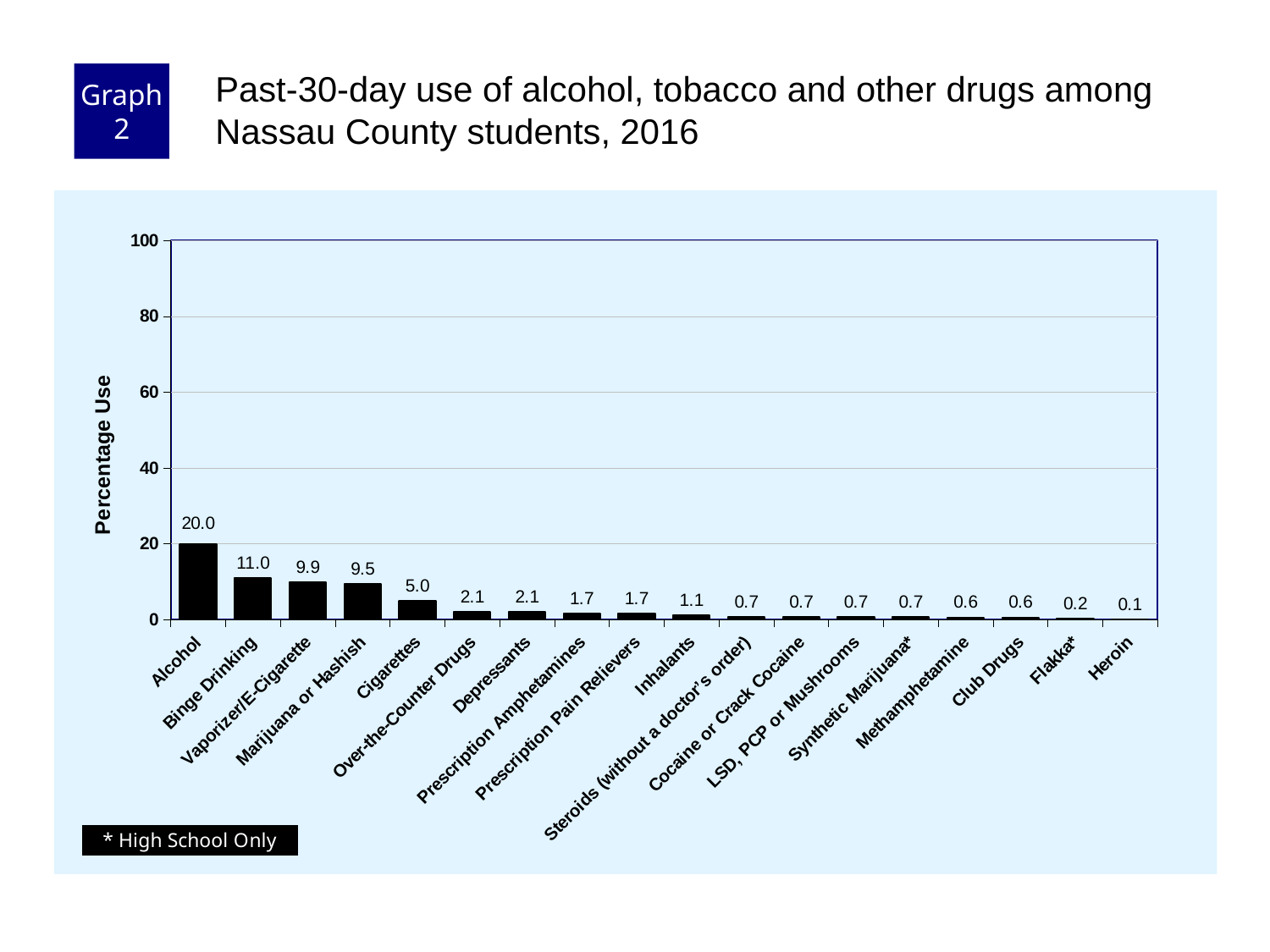
What is the past-30-day use percentage for Alcohol? 20.0 What is the value shown for Inhalants? 1.1 What is the difference between the values for Alcohol and Binge Drinking? 9.0 Which is larger, the value for Cigarettes or the value for Over-the-Counter Drugs? Cigarettes What is the value shown for Cigarettes? 5.0 How many categories are shown on the x axis? 18 Is the value for Binge Drinking greater or less than 20? less What is the difference between the values for Vaporizer/E-Cigarette and Marijuana or Hashish? 0.4 What is the value shown for Heroin? 0.1 What type of chart is shown on the slide? Bar chart Which category has the lowest percentage use? Heroin Which category has the highest percentage use? Alcohol